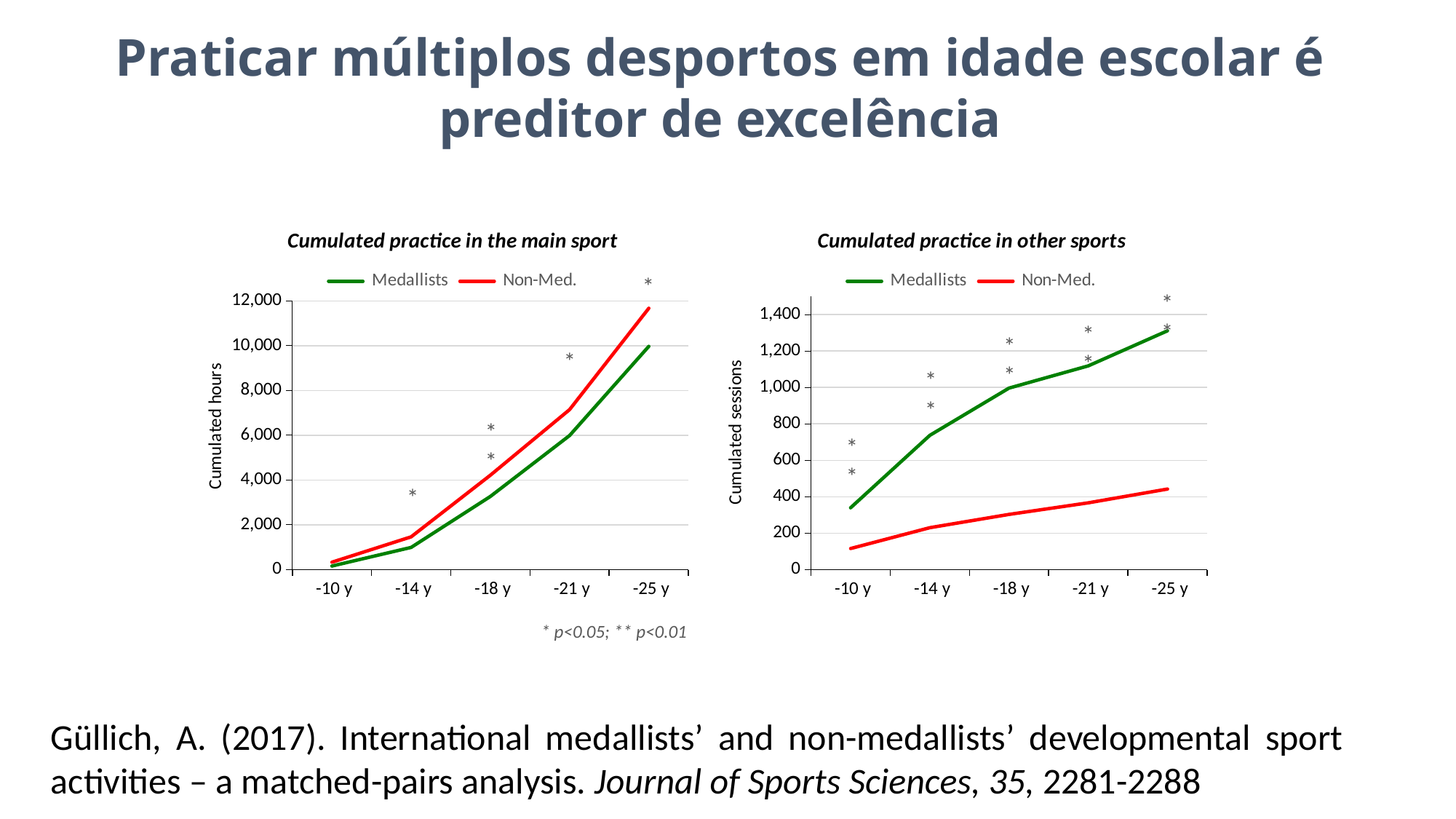
What is the y-axis label of the 'Cumulated practice in other sports' chart? Cumulated sessions In the 'Cumulated practice in the main sport' chart, do the values for Medallists rise or fall from -10 y to -25 y? rise In the 'Cumulated practice in other sports' chart, is the value for Medallists at -25 y greater or less than 1,200? greater What kind of chart is the 'Cumulated practice in the main sport' chart? line chart In the 'Cumulated practice in the main sport' chart, is the value for Medallists at -18 y greater or less than 4,000? less In the 'Cumulated practice in the main sport' chart, what colour is the Medallists line? green In the 'Cumulated practice in other sports' chart, is the value for Non-Med. at -10 y greater or less than 200? less How many age categories are shown on the x axis of the 'Cumulated practice in the main sport' chart? 5 How many series does the legend of the 'Cumulated practice in other sports' chart list? 2 In the 'Cumulated practice in the main sport' chart, which series is higher at -25 y, Medallists or Non-Med.? Non-Med. In the 'Cumulated practice in other sports' chart, which series is higher at -18 y, Medallists or Non-Med.? Medallists